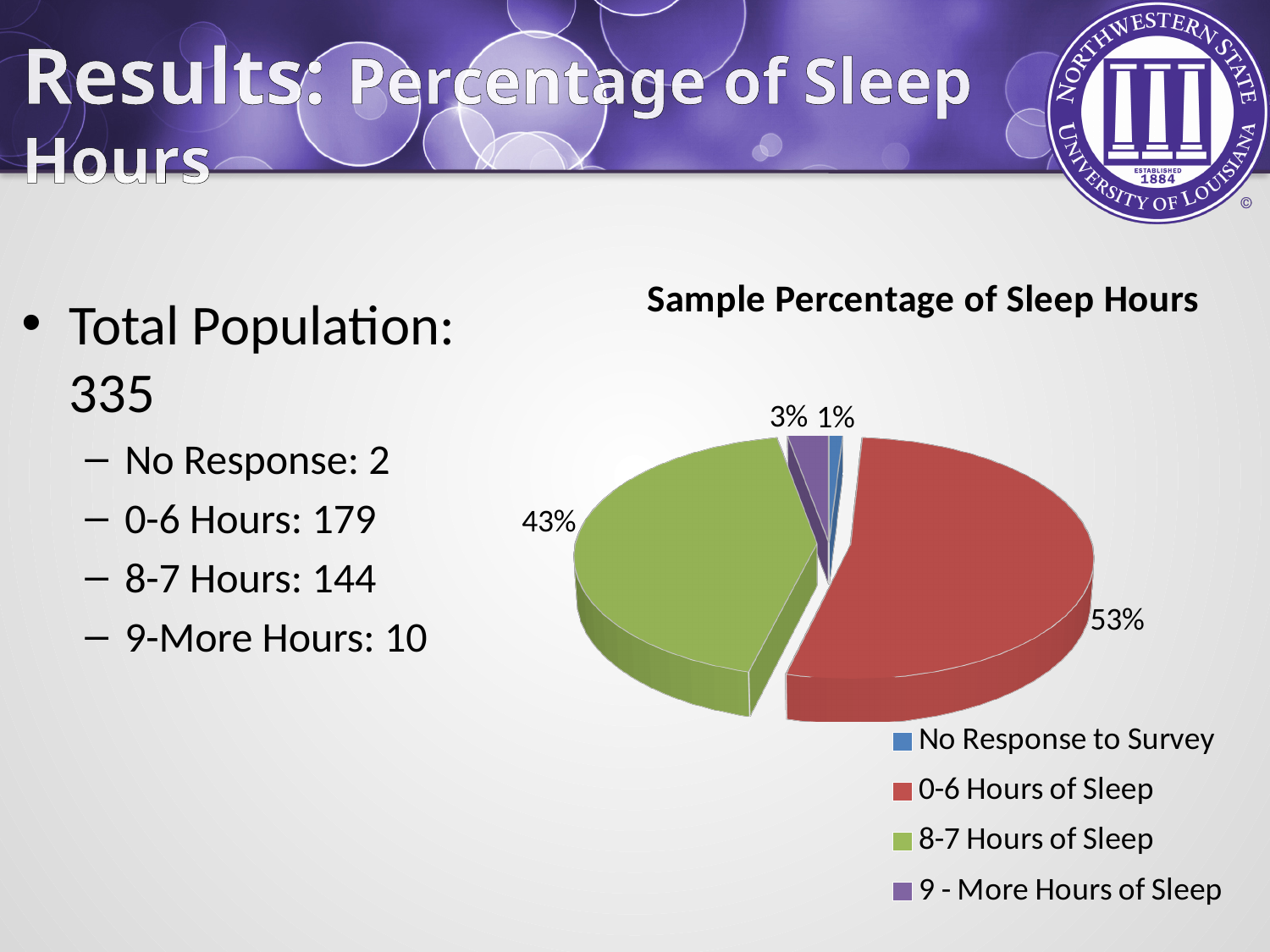
What percentage of the pie is No Response to Survey? 1% Which colour represents 8-7 Hours of Sleep in the legend? green Which category has the largest share of the pie? 0-6 Hours of Sleep How many slices does the pie chart have? 4 What type of chart is shown on the slide? pie chart Which category has the smallest share of the pie? No Response to Survey What percentage of the pie is 0-6 Hours of Sleep? 53% What percentage of the pie is 8-7 Hours of Sleep? 43% What percentage of the pie is 9 - More Hours of Sleep? 3% Which is larger, the share for 9 - More Hours of Sleep or the share for No Response to Survey? 9 - More Hours of Sleep What is the title of the chart? Sample Percentage of Sleep Hours What is the difference in percentage points between 0-6 Hours of Sleep and 8-7 Hours of Sleep? 10